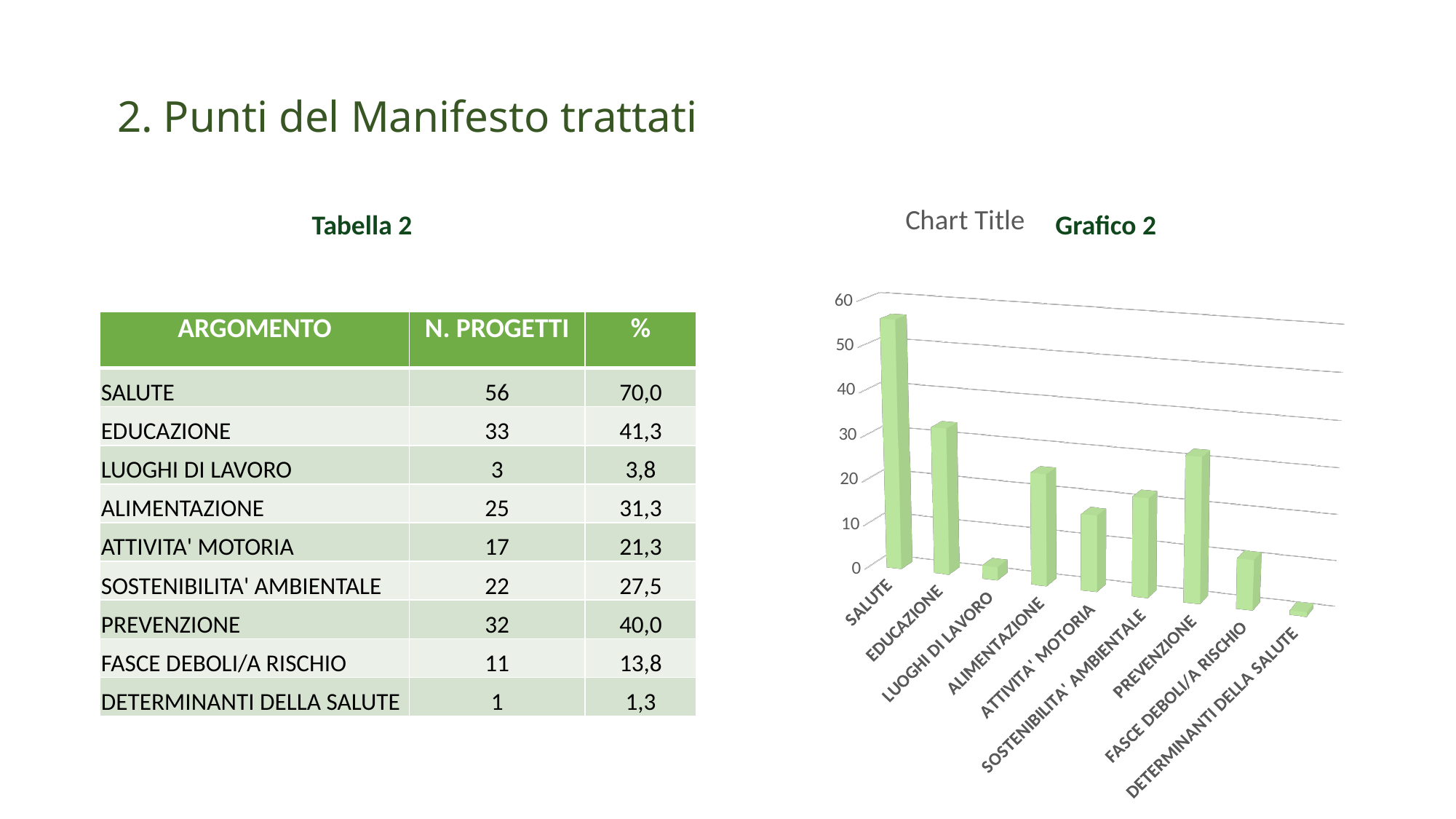
What is the difference in number of projects between SALUTE and EDUCAZIONE, as shown on the slide? 23 How many categories are shown on the x axis of the chart? 9 Which bar is taller in the chart, ALIMENTAZIONE or ATTIVITA' MOTORIA? ALIMENTAZIONE What is the placeholder title printed above the chart? Chart Title Which category has the tallest bar in the chart? SALUTE What kind of chart is Grafico 2? bar chart Which category has the shortest bar in the chart? DETERMINANTI DELLA SALUTE Is the value for FASCE DEBOLI/A RISCHIO in the chart greater or less than 20? less Is the value for PREVENZIONE in the chart greater or less than 20? greater According to the slide, how many projects (N. PROGETTI) does the SALUTE bar represent? 56 Is the value for SALUTE in the chart greater or less than 50? greater